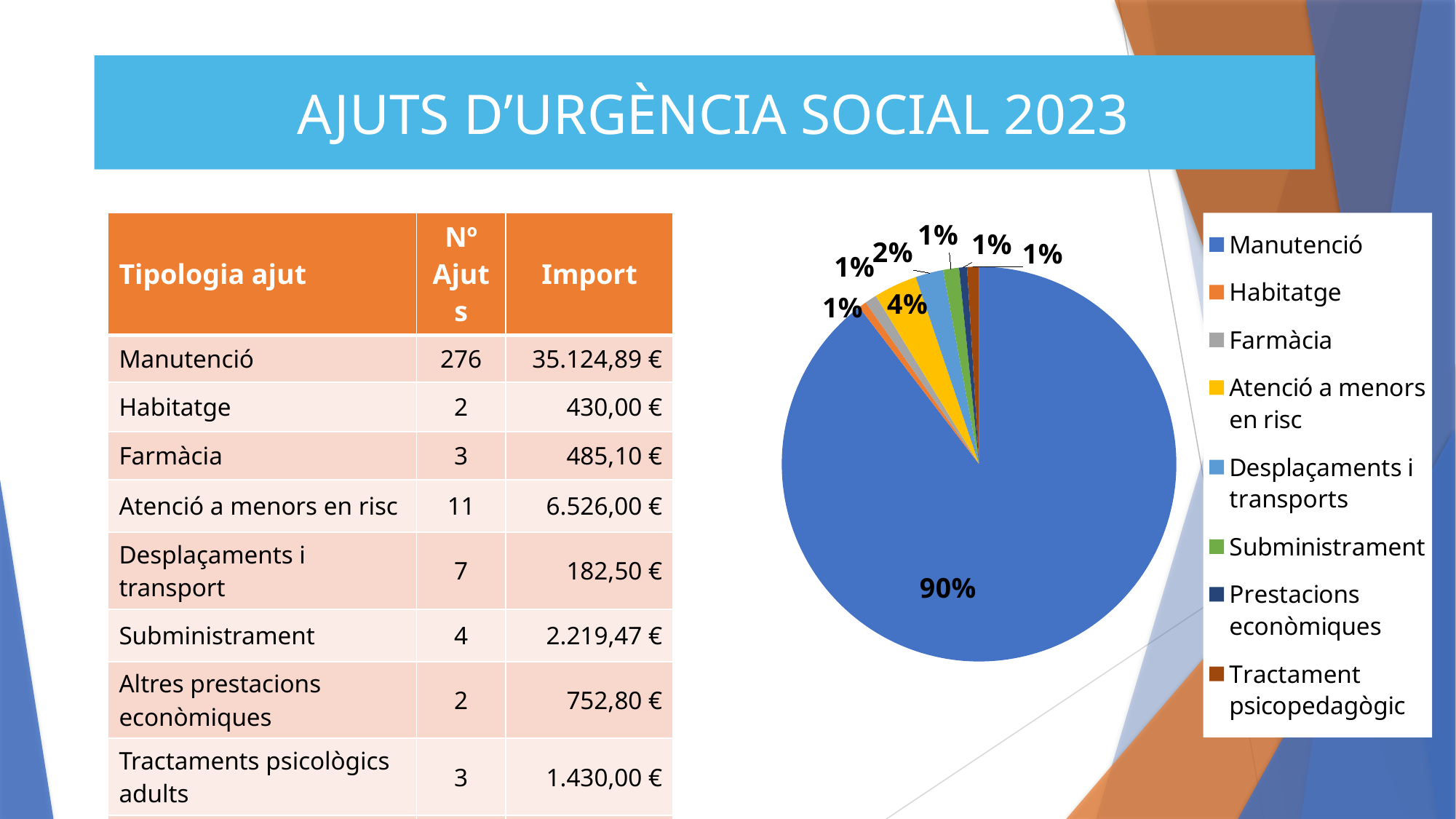
How many entries does the pie chart's legend list? 8 Which legend entry is shown in yellow? Atenció a menors en risc Which is larger in the pie chart, Atenció a menors en risc or Desplaçaments i transports? Atenció a menors en risc How many slices does the pie chart have? 8 What is the difference in percentage points between the Manutenció slice and the Atenció a menors en risc slice? 86% What percentage is shown for Desplaçaments i transports in the pie chart? 2% What percentage is shown for Atenció a menors en risc in the pie chart? 4% What percentage is shown for Habitatge in the pie chart? 1% What kind of chart is shown on the slide? pie chart What colour is the Manutenció slice in the pie chart? blue Which category has the largest slice in the pie chart? Manutenció What share of the pie does Manutenció represent? 90%